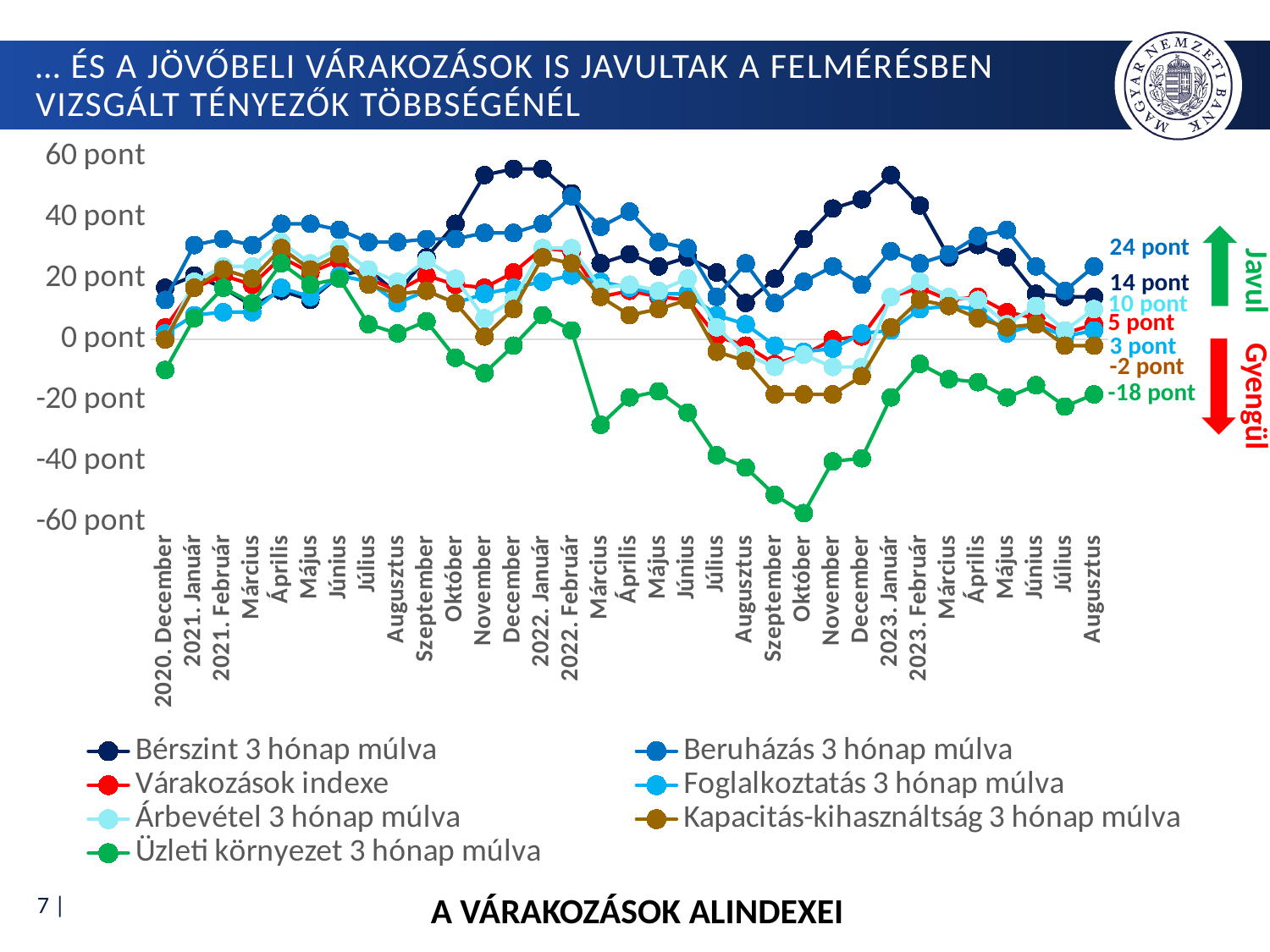
How many series does the legend list? 7 Which series has the lowest value at the end of the series (2023 Augusztus)? Üzleti környezet 3 hónap múlva Is the value of Bérszint 3 hónap múlva in 2022 Január greater or less than 40 pont? greater Which series has the highest value at the end of the series (2023 Augusztus)? Beruházás 3 hónap múlva How many months are shown on the x axis? 33 What is the value of Bérszint 3 hónap múlva at the end of the series (2023 Augusztus)? 14 pont What type of chart is shown on the slide? line chart Is the value of Üzleti környezet 3 hónap múlva in 2022 Október greater or less than -40 pont? less What is the value of Beruházás 3 hónap múlva at the end of the series (2023 Augusztus)? 24 pont What is the value of Üzleti környezet 3 hónap múlva at the end of the series (2023 Augusztus)? -18 pont What is the value of Várakozások indexe at the end of the series (2023 Augusztus)? 5 pont What is the difference between the end values of Beruházás 3 hónap múlva (24 pont) and Üzleti környezet 3 hónap múlva (-18 pont)? 42 pont